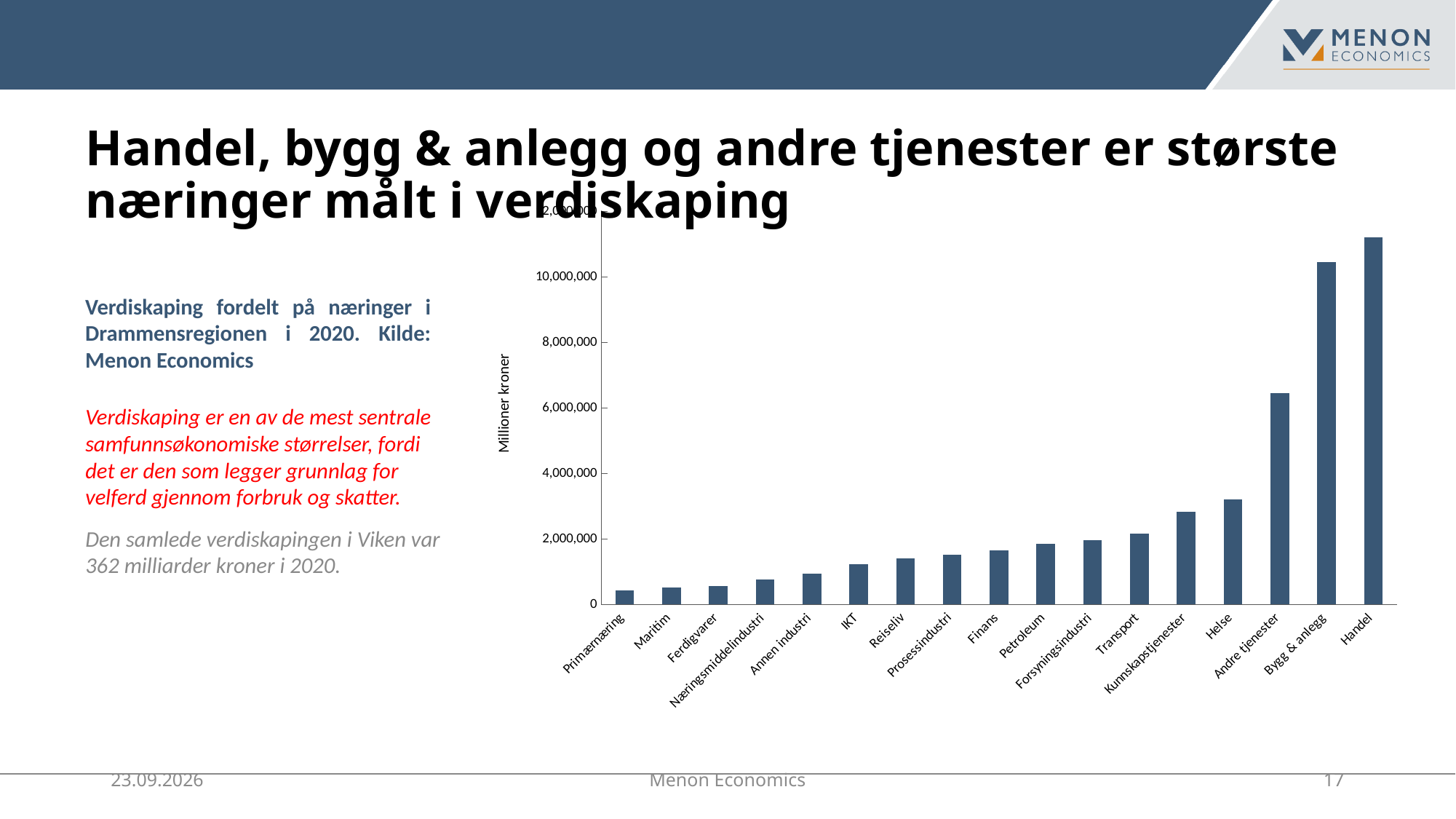
Which is larger, the value for Helse or the value for Andre tjenester? Andre tjenester Is the value for Bygg & anlegg greater or less than 8,000,000? greater What kind of chart is shown on the slide? bar chart What is the label on the vertical axis of the chart? Millioner kroner Do the bar values rise or fall from left to right along the x axis? rise Is the value for Handel greater or less than 10,000,000? greater How many categories are shown on the x axis of the chart? 17 Which category has the lowest value in the chart? Primærnæring Is the value for Helse greater or less than 4,000,000? less Which category has the highest value in the chart? Handel